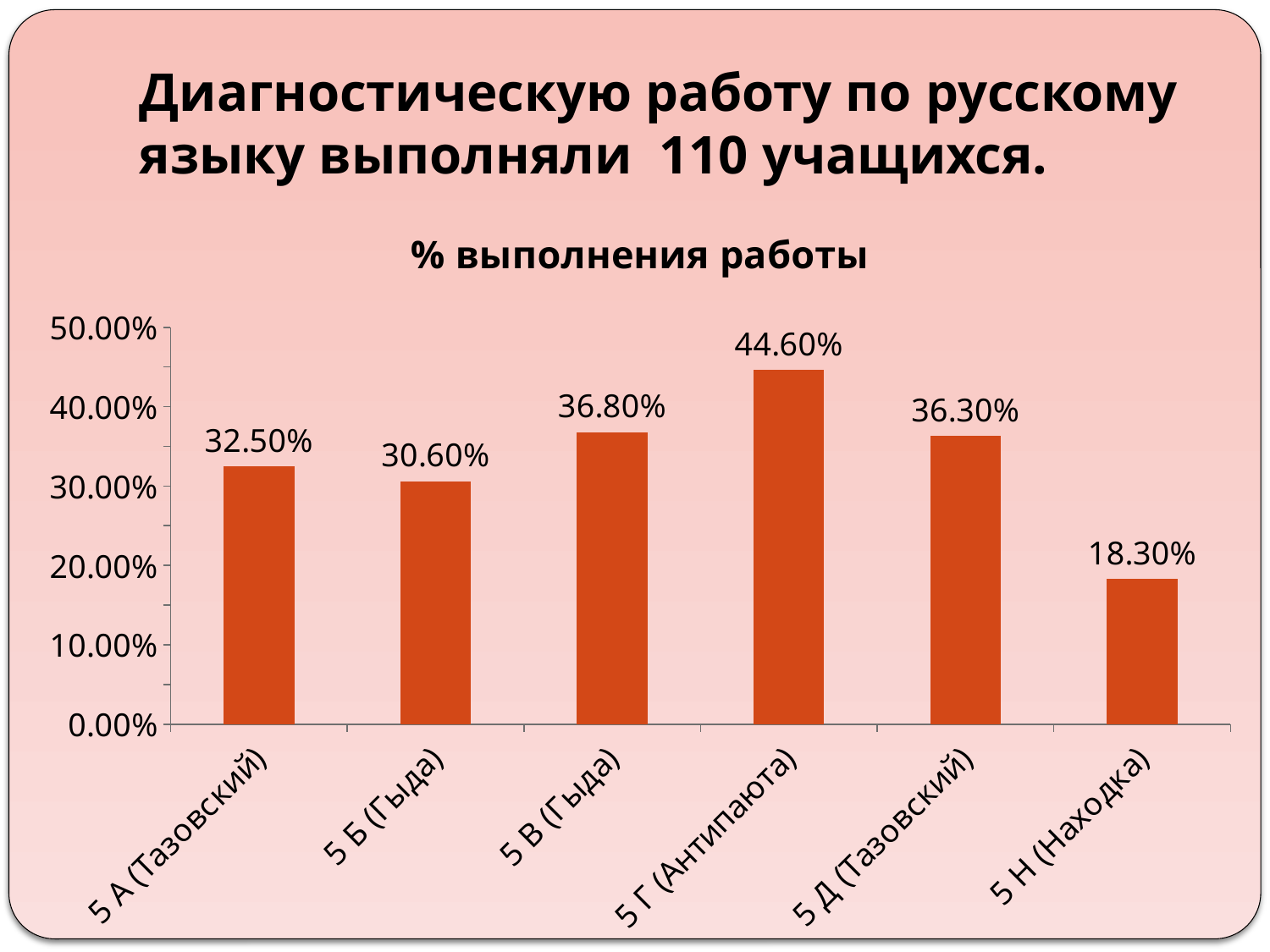
How many categories are shown in the chart? 6 What is the value for 5 А (Тазовский)? 32.50% What is the difference between the values for 5 В (Гыда) and 5 Д (Тазовский)? 0.50% What is the title of the chart? % выполнения работы What is the value for 5 Б (Гыда)? 30.60% Which is larger, the value for 5 А (Тазовский) or 5 Б (Гыда)? 5 А (Тазовский) What is the value for 5 Г (Антипаюта)? 44.60% What is the value for 5 Н (Находка)? 18.30% What is the difference between the values for 5 Г (Антипаюта) and 5 Н (Находка)? 26.30% What kind of chart is shown on the slide? Bar chart Which category has the lowest value? 5 Н (Находка) Which category has the highest value? 5 Г (Антипаюта)